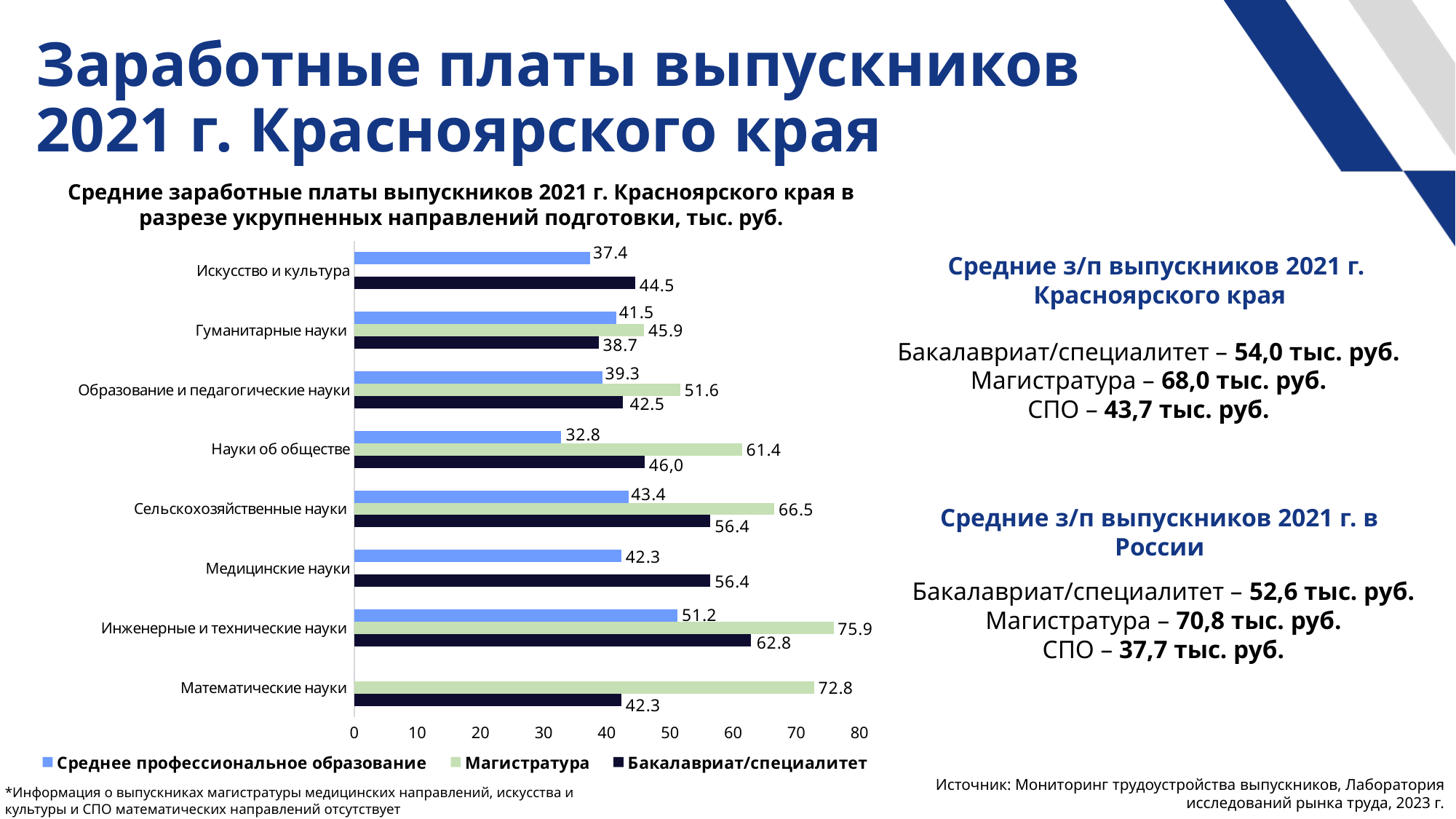
Which category has the lowest value for Среднее профессиональное образование? Науки об обществе Which is larger for Гуманитарные науки: the value for Среднее профессиональное образование or for Бакалавриат/специалитет? Среднее профессиональное образование Is the value for Магистратура in Математические науки greater or less than 70? greater What is the difference between the Магистратура and Бакалавриат/специалитет values for Сельскохозяйственные науки? 10.1 What is the value for Бакалавриат/специалитет in the category Математические науки? 42.3 What is the value for Магистратура in the category Инженерные и технические науки? 75.9 What type of chart is shown on the slide? Bar chart What is the value for Среднее профессиональное образование in the category Науки об обществе? 32.8 Which series is shown in light green in the chart legend? Магистратура How many categories (directions of training) are shown on the chart's vertical axis? 8 How many series does the chart legend list? 3 Which category has the highest value for Магистратура? Инженерные и технические науки